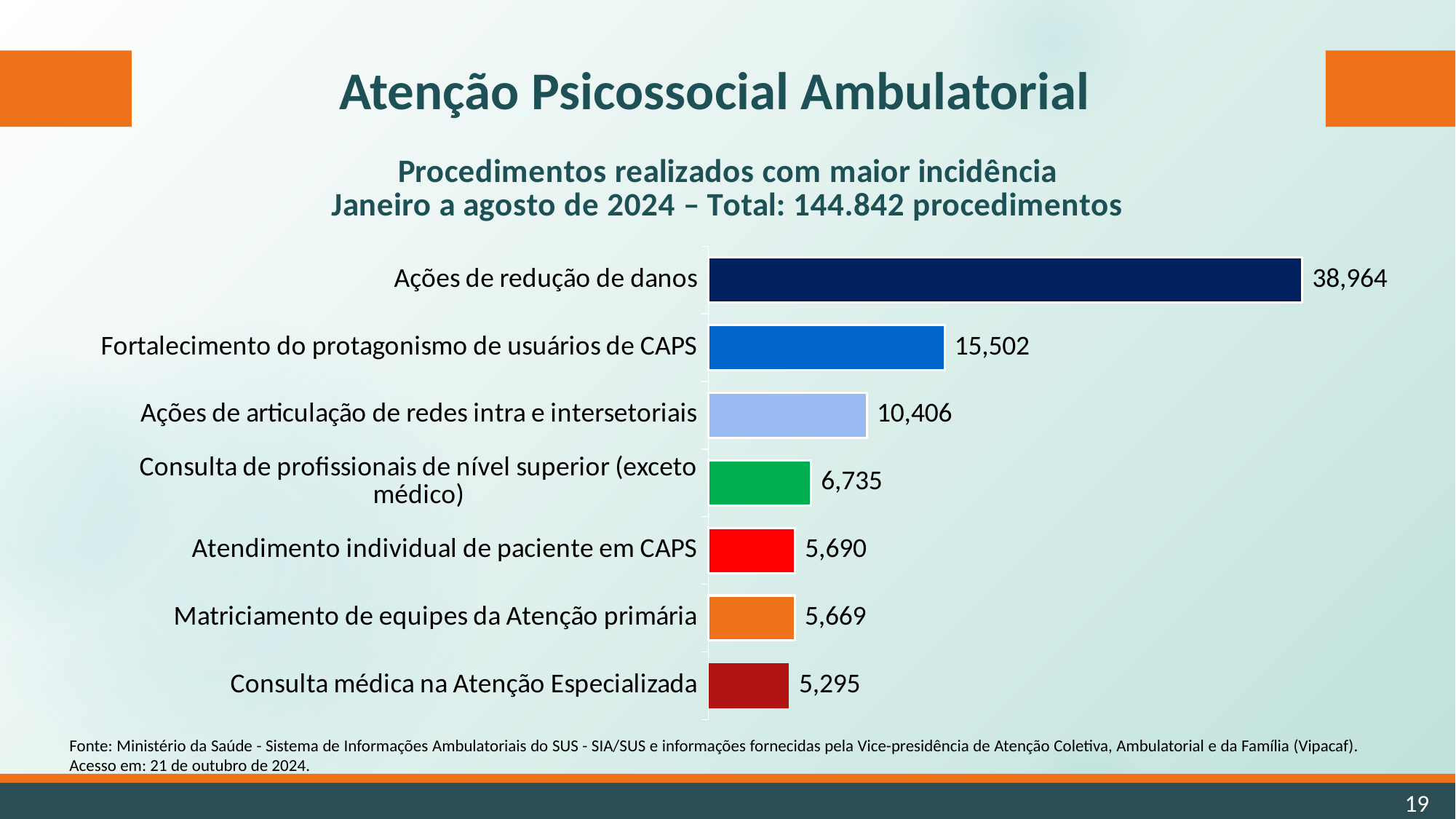
What is the difference between Ações de redução de danos and Fortalecimento do protagonismo de usuários de CAPS? 23,462 What kind of chart is shown on the slide? Bar chart Which is larger: Consulta de profissionais de nível superior (exceto médico) or Consulta médica na Atenção Especializada? Consulta de profissionais de nível superior (exceto médico) How many categories are shown in the chart? 7 Which category has the highest value? Ações de redução de danos Which category has the lowest value? Consulta médica na Atenção Especializada What is the value for Ações de redução de danos? 38,964 What is the value for Matriciamento de equipes da Atenção primária? 5,669 What is the value for Fortalecimento do protagonismo de usuários de CAPS? 15,502 What is the difference between Atendimento individual de paciente em CAPS and Matriciamento de equipes da Atenção primária? 21 According to the chart subtitle, what is the total number of procedures from January to August 2024? 144.842 procedimentos What is the value for Consulta de profissionais de nível superior (exceto médico)? 6,735